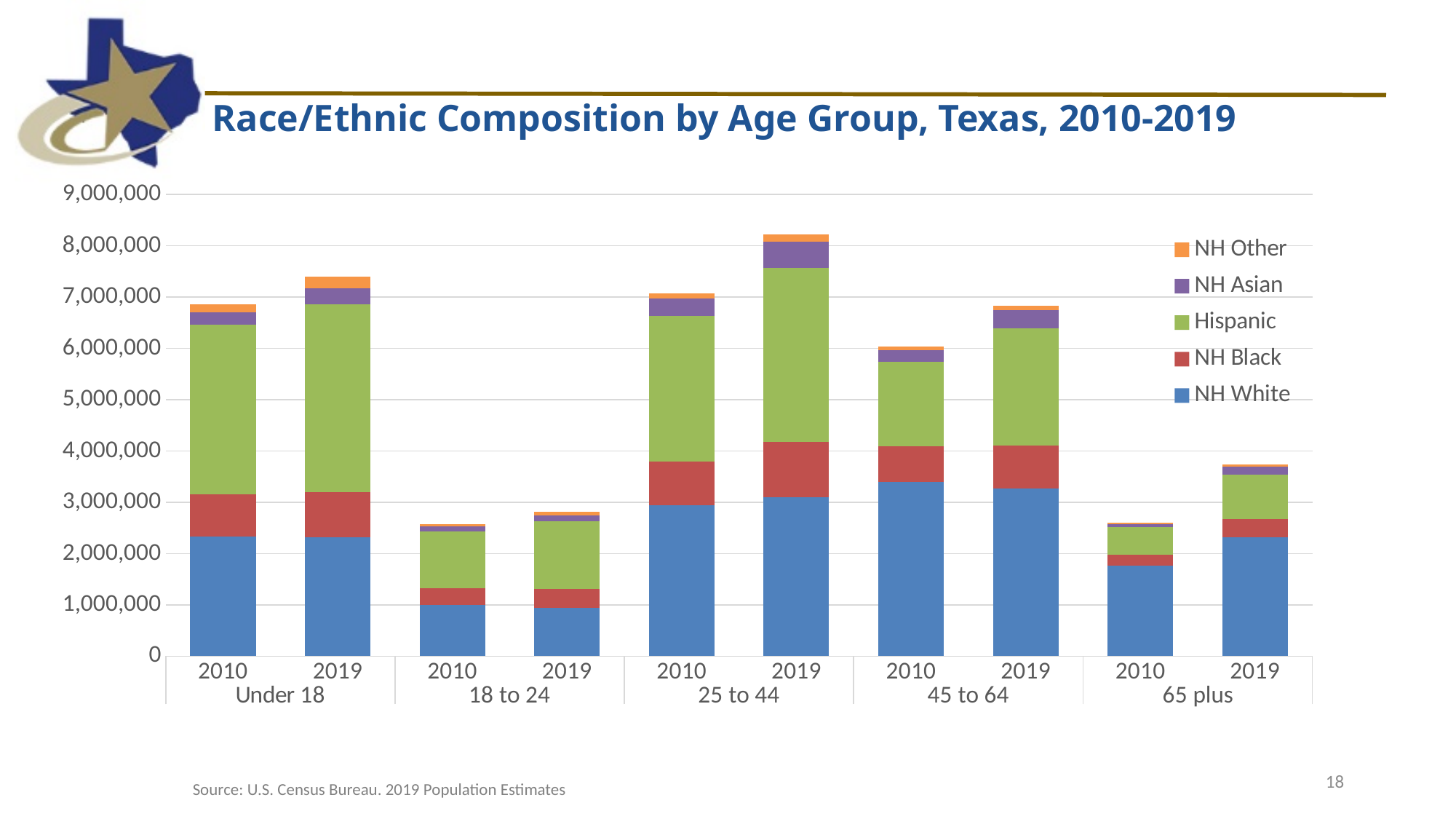
Which bar has the highest total population? 25 to 44, 2019 What kind of chart is shown on the slide? Stacked bar chart Is the total for the 65 plus age group in 2019 greater or less than 4,000,000? less How many bars are plotted in total on the chart? 10 Which is larger: the 2019 total for Under 18 or the 2019 total for 45 to 64? Under 18 How many age groups are shown along the x axis? 5 How many series does the legend list? 5 Is the total for the 25 to 44 age group in 2019 greater or less than 8,000,000? greater Which series is shown in green? Hispanic Is the total for the 18 to 24 age group in 2010 greater or less than 3,000,000? less Within each age group, does the total population rise or fall from 2010 to 2019? Rise